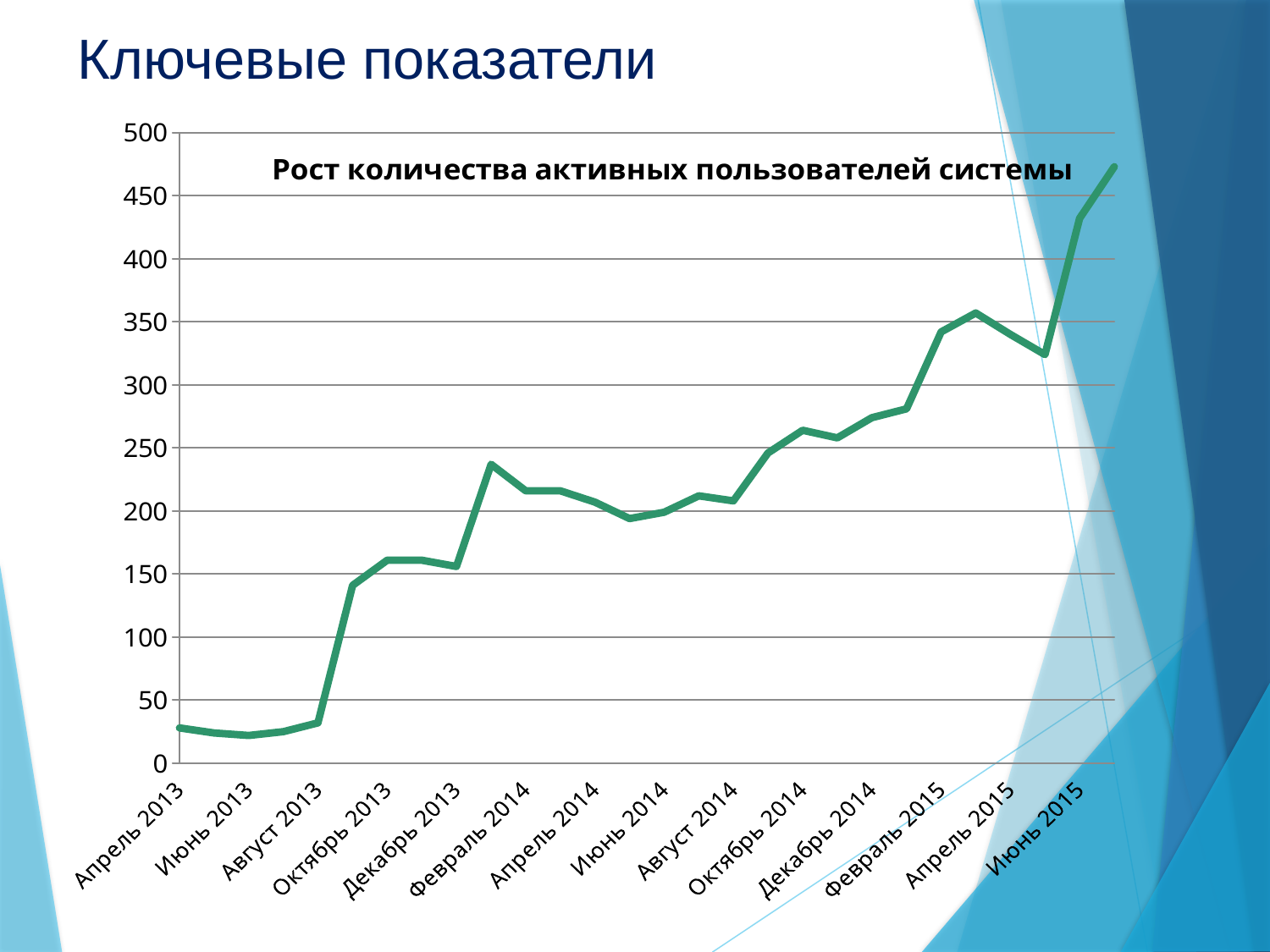
How many month labels are shown on the x axis? 14 Which is larger, the value for Февраль 2015 or the value for Февраль 2014? Февраль 2015 Is the value for Апрель 2013 greater or less than 50? less What is the title of the chart? Рост количества активных пользователей системы Is the value for Август 2013 greater or less than 50? less Is the value for Февраль 2015 greater or less than 300? greater Which labeled month has the highest value? Июнь 2015 What kind of chart is shown on the slide? line chart Overall, do the values rise or fall from Апрель 2013 to Июнь 2015? rise